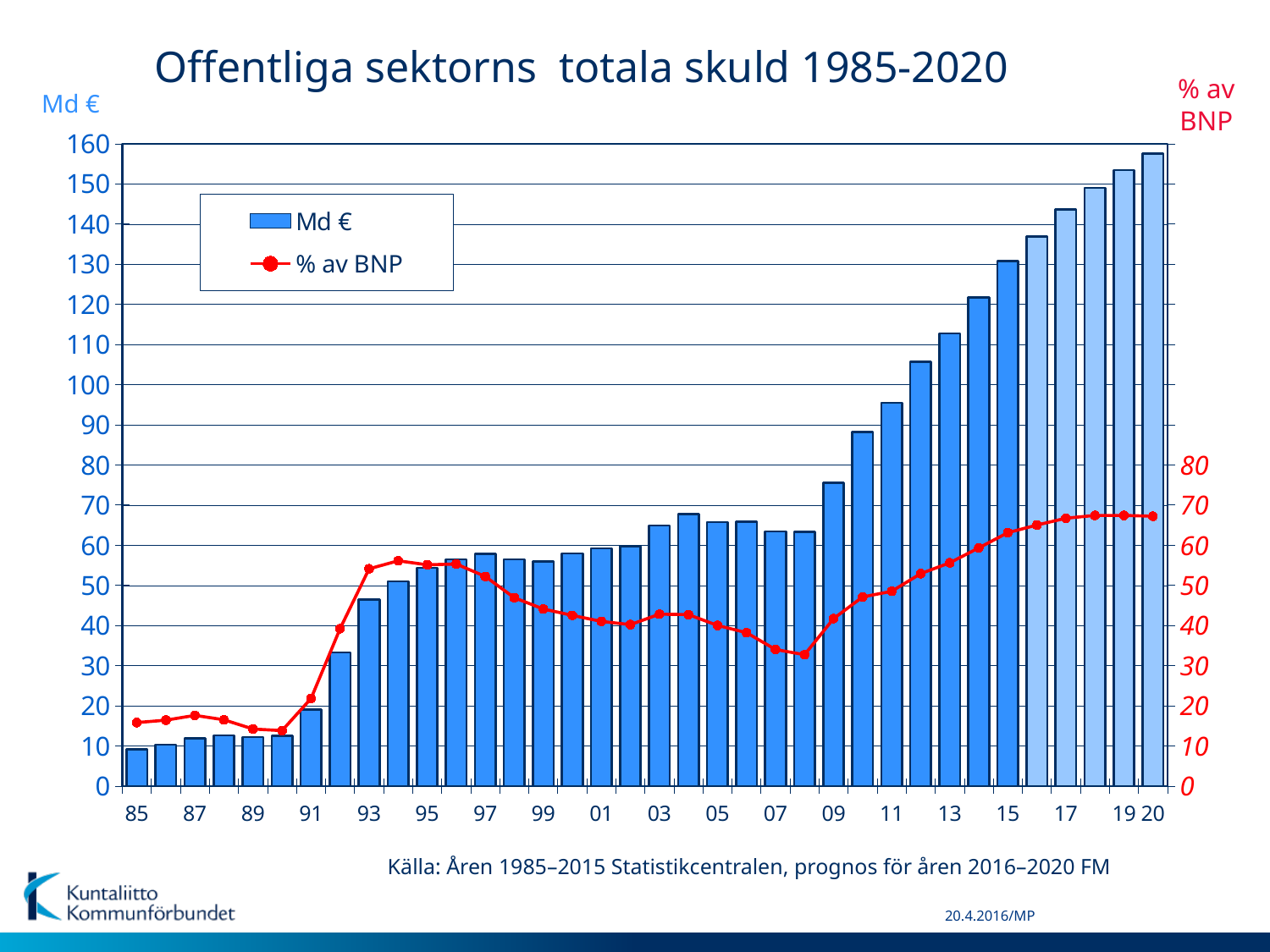
Which year has the highest Md € bar? 2020 Is the Md € value for 2020 greater or less than 150? greater Is the % av BNP value for 1994 greater or less than 50? greater What kind of chart is shown on the slide? A combined bar and line chart What is the title of the chart? Offentliga sektorns totala skuld 1985-2020 How many years (bars) are plotted in the chart? 36 Is the % av BNP value for 2008 greater or less than 40? less Do the Md € bars rise or fall from 2008 to 2020? rise Which is larger, the Md € bar for 2009 or for 2008? 2009 Which year has the lowest Md € bar? 1985 How many series does the legend list? 2